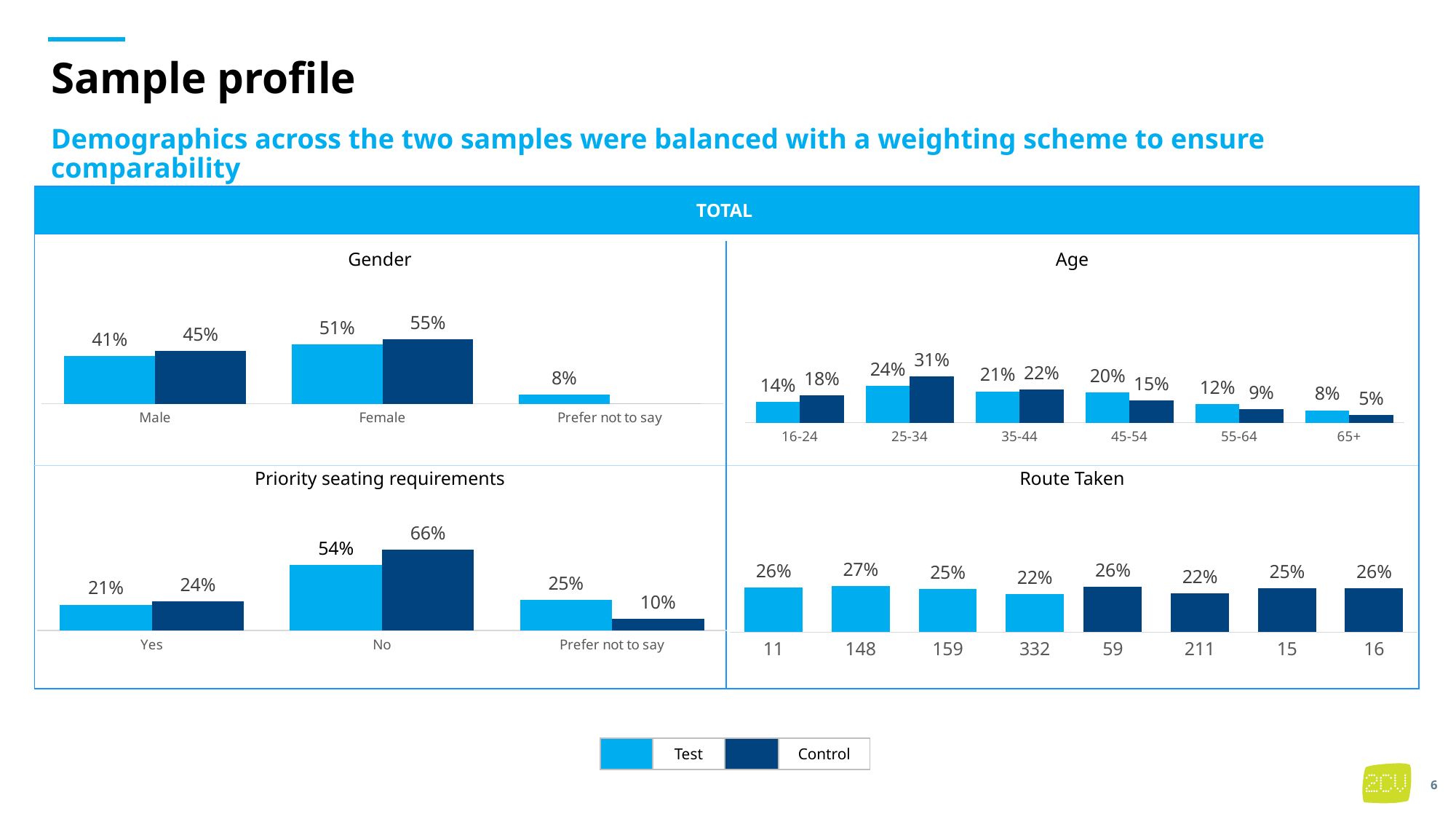
In the Age chart, which age group has the highest Control value? 25-34 In the Age chart, do the Control values rise or fall from the 25-34 group to the 65+ group? Fall What kind of chart is the Age chart? Bar chart In the Route Taken chart, what is the value for route 148? 27% In the Gender chart, what is the difference between the Control and Test values for Male? 4% In the Age chart, what is the Test value for the 45-54 age group? 20% In the Route Taken chart, how many routes are shown? 8 How many series does the legend at the bottom of the slide list? 2 In the Priority seating requirements chart, what is the difference between the Control and Test values for No? 12% In the Gender chart, what is the Control value for Female? 55% In the Age chart, which age group has the lowest Test value? 65+ In the Priority seating requirements chart, which is larger for Prefer not to say: the Test value or the Control value? Test